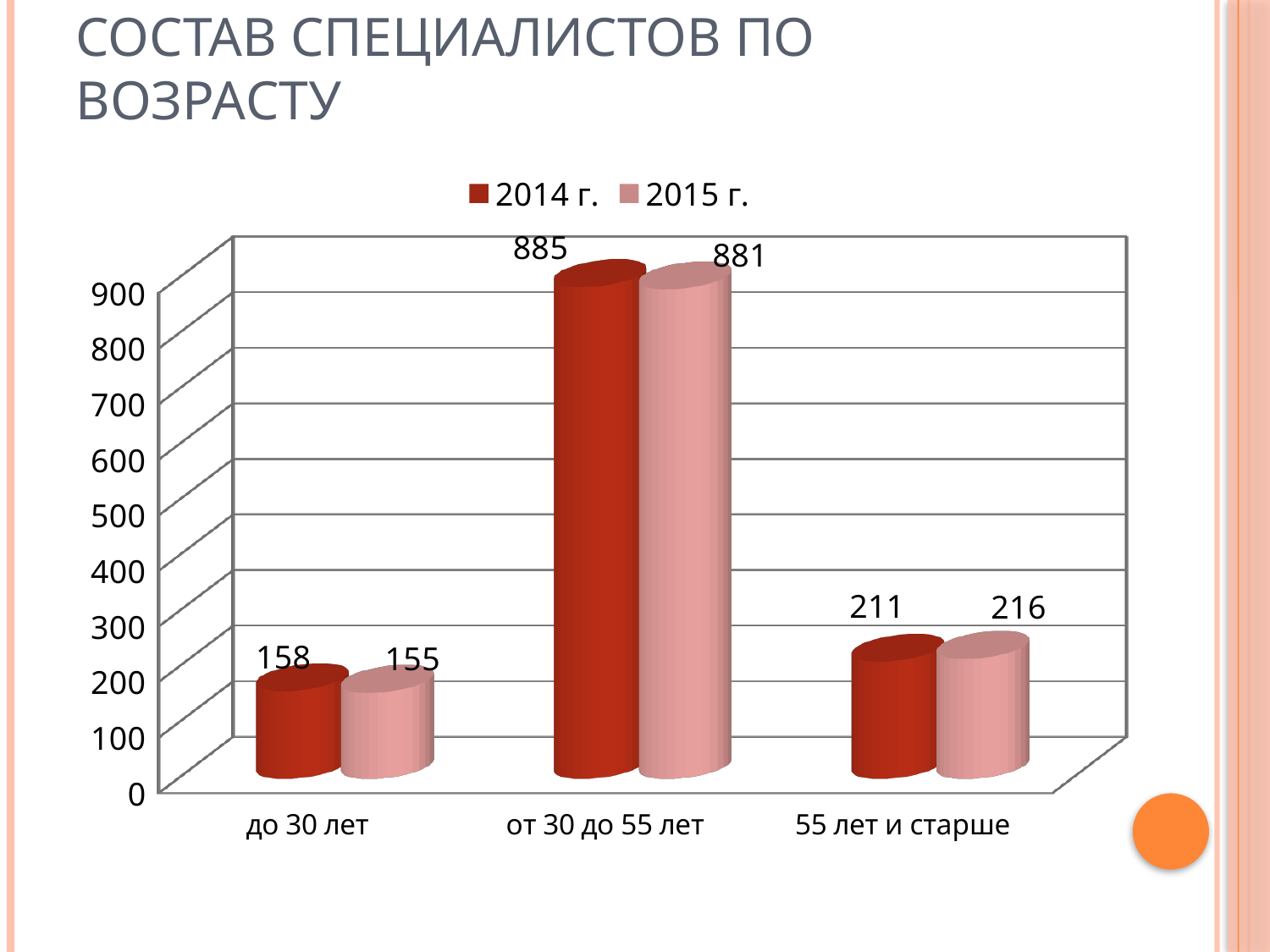
Which category has the highest value for 2014 г.? от 30 до 55 лет What is the difference between the 2014 г. and 2015 г. values for 'от 30 до 55 лет'? 4 What kind of chart is shown on the slide? bar chart Which category has the lowest value for 2015 г.? до 30 лет What is the value for 2015 г. in the category 'до 30 лет'? 155 What is the title of the slide? Состав специалистов по возрасту How many series does the legend list? 2 What is the value for 2015 г. in the category '55 лет и старше'? 216 Which is larger: the 2014 г. value for '55 лет и старше' or the 2014 г. value for 'до 30 лет'? 55 лет и старше What is the value for 2014 г. in the category 'от 30 до 55 лет'? 885 What is the difference between the 2015 г. values for '55 лет и старше' and 'до 30 лет'? 61 How many categories are shown on the x axis? 3